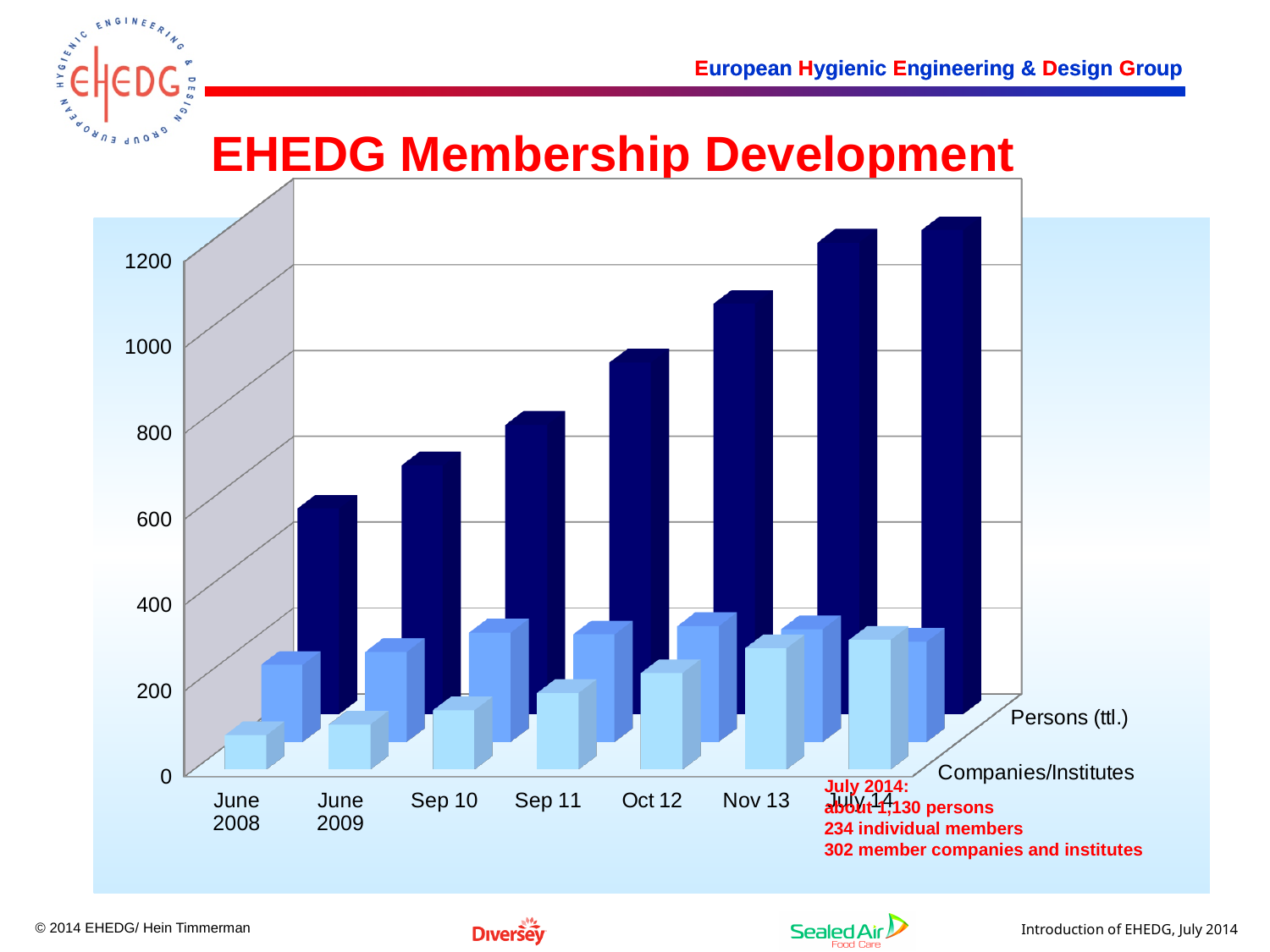
What kind of chart is shown on the slide? bar chart Which time period has the lowest value for Companies/Institutes? June 2008 Is the value for Persons (ttl.) in June 2008 greater or less than 800? less According to the note on the slide, how many member companies and institutes were there in July 2014? 302 How many time periods are shown along the x axis of the chart? 7 Is the value for Persons (ttl.) in Nov 13 greater or less than 1000? greater Which is larger, the Persons (ttl.) value for Nov 13 or for June 2009? Nov 13 Which time period has the highest value for Persons (ttl.)? July 14 Is the value for Companies/Institutes in June 2008 greater or less than 200? less Which time period has the lowest value for Persons (ttl.)? June 2008 What is the title of the chart? EHEDG Membership Development Do the values for Persons (ttl.) rise or fall from June 2008 to July 14? rise